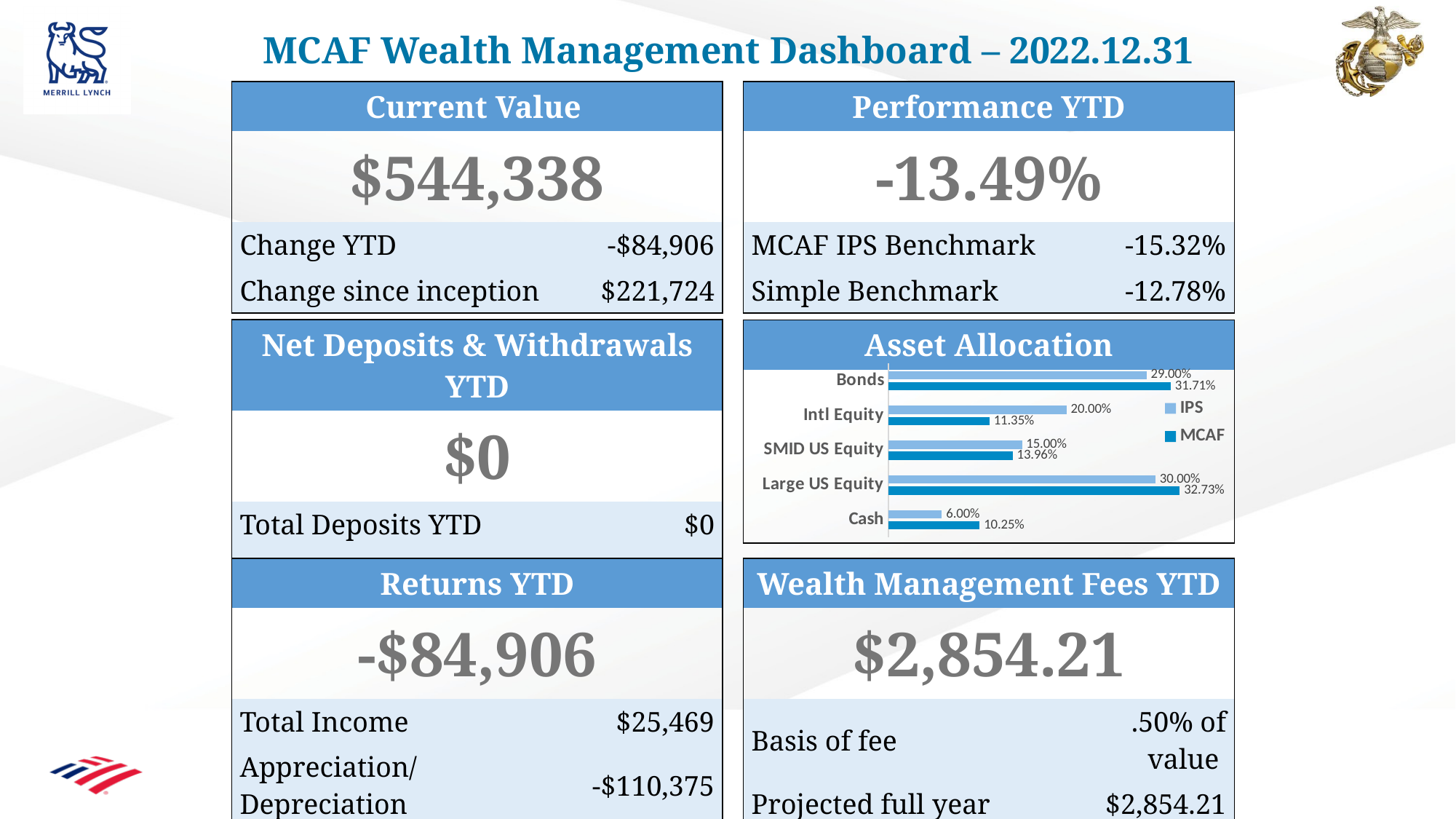
In the Asset Allocation chart, what is the MCAF value for Cash? 10.25% In the Asset Allocation chart, what is the MCAF value for Bonds? 31.71% In the Asset Allocation chart, what is the IPS value for SMID US Equity? 15.00% In the Asset Allocation chart, which series is shown in the darker blue colour? MCAF In the Asset Allocation chart, which category has the lowest IPS value? Cash What type of chart is the Asset Allocation chart? Bar chart How many series does the legend of the Asset Allocation chart list? 2 How many categories are shown in the Asset Allocation chart? 5 In the Asset Allocation chart, what is the difference between the IPS and MCAF values for Intl Equity? 8.65% In the Asset Allocation chart, what is the IPS value for Intl Equity? 20.00% In the Asset Allocation chart, which is larger for Large US Equity, the IPS value or the MCAF value? MCAF In the Asset Allocation chart, which category has the highest MCAF value? Large US Equity